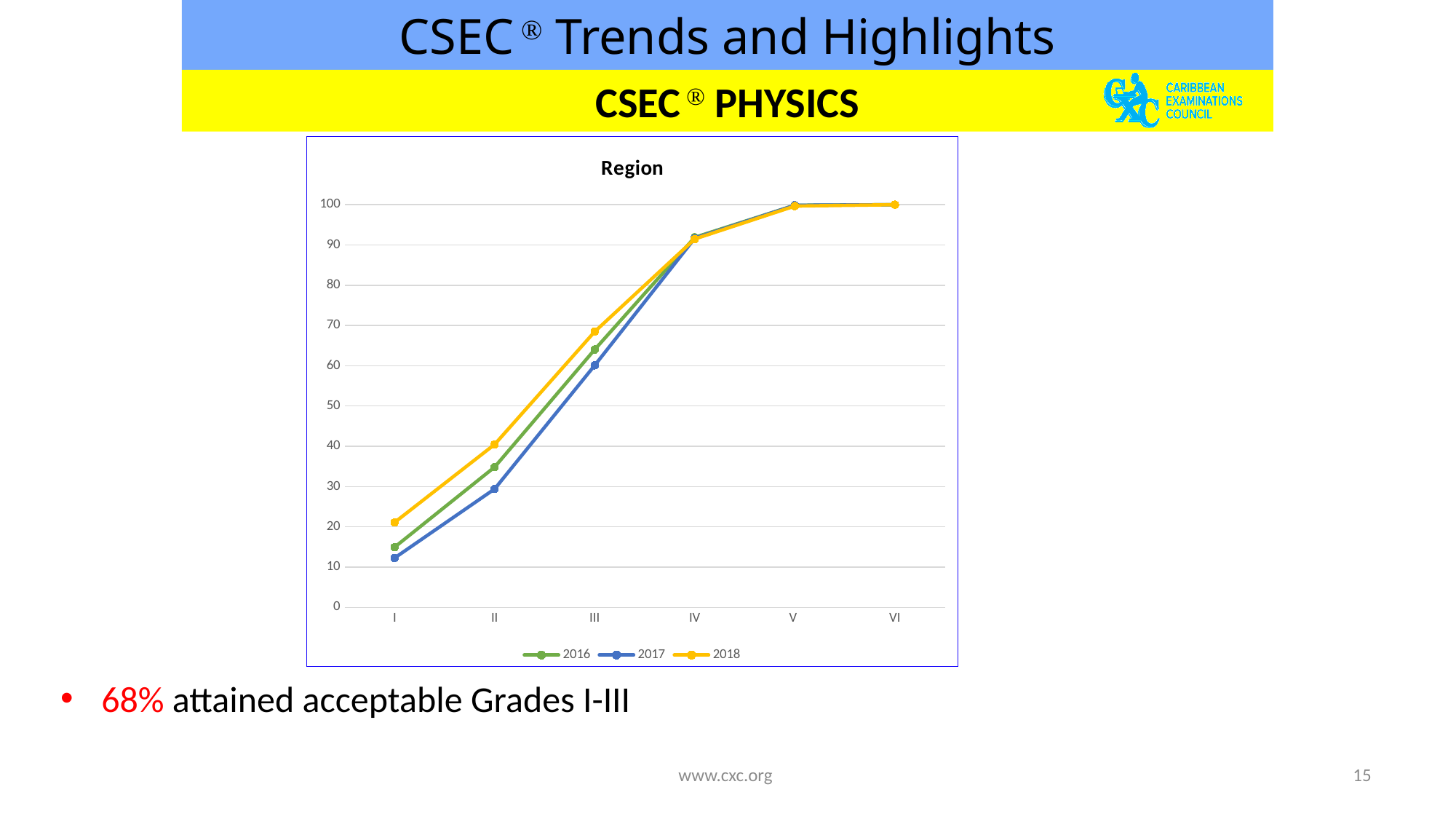
At grade II, which series has the highest value? 2018 Is the value for 2018 at grade I greater or less than 20? greater What is the title of the chart? Region Is the value for 2016 at grade III greater or less than 60? greater Is the value for 2017 at grade IV greater or less than 90? greater Do the values for the 2018 series rise or fall from grade I to grade VI? rise How many categories are shown on the x axis of the chart? 6 What kind of chart is shown on the slide? line chart At grade III, which is larger: the value for 2016 or the value for 2017? 2016 How many series does the legend of the chart list? 3 Which years are listed in the chart's legend? 2016, 2017, 2018